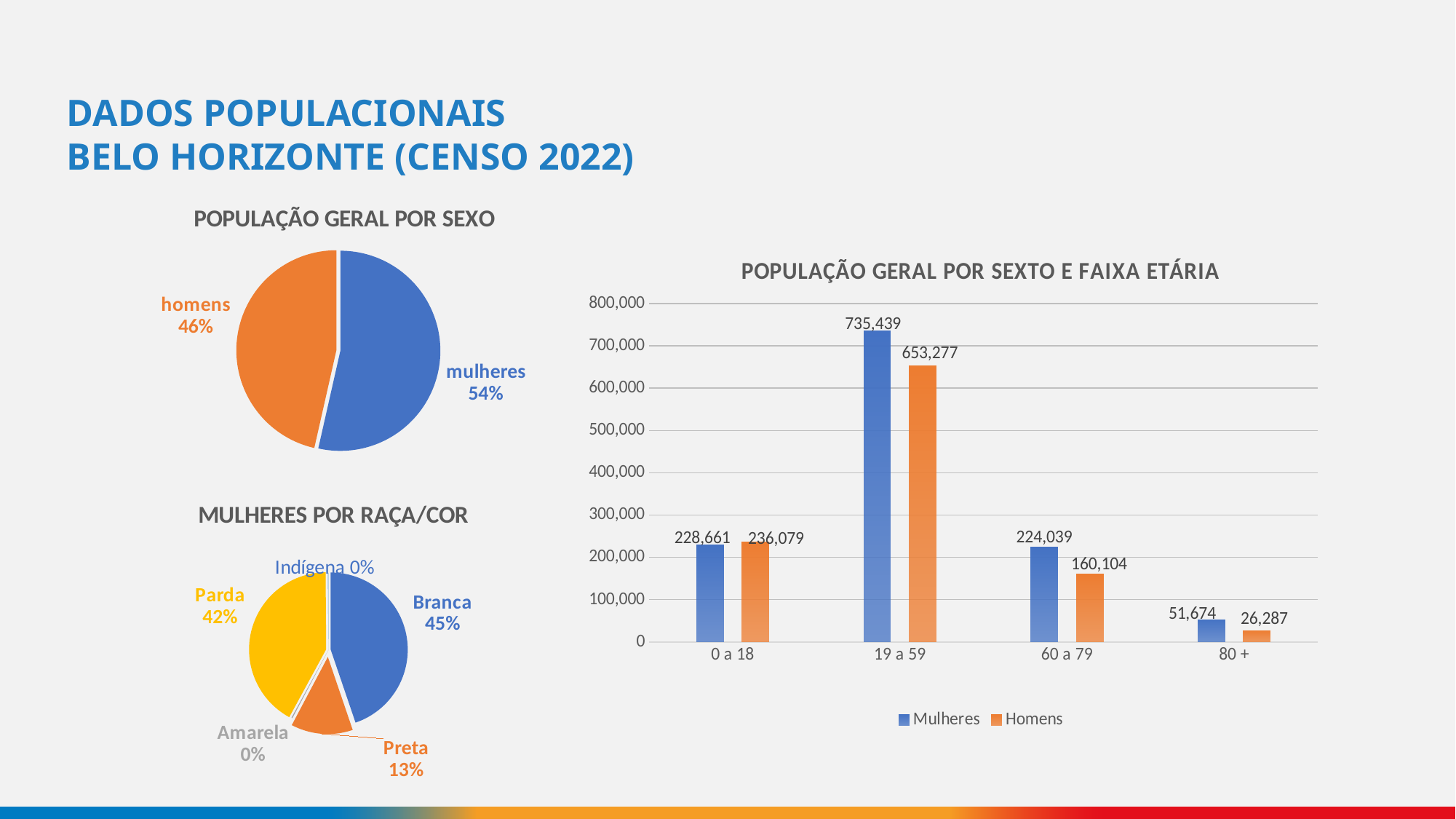
In the chart 'POPULAÇÃO GERAL POR SEXTO E FAIXA ETÁRIA', what is the difference between Mulheres and Homens in the 60 a 79 age group? 63,935 In the chart 'POPULAÇÃO GERAL POR SEXTO E FAIXA ETÁRIA', which is larger in the 0 a 18 age group, Mulheres or Homens? Homens In the chart 'POPULAÇÃO GERAL POR SEXTO E FAIXA ETÁRIA', which age group has the highest value for Homens? 19 a 59 In the chart 'POPULAÇÃO GERAL POR SEXTO E FAIXA ETÁRIA', what is the value for Homens in the 80 + age group? 26,287 How many age groups are shown in the chart 'POPULAÇÃO GERAL POR SEXTO E FAIXA ETÁRIA'? 4 What kind of chart is 'POPULAÇÃO GERAL POR SEXTO E FAIXA ETÁRIA'? Bar chart In the pie chart 'MULHERES POR RAÇA/COR', what share is Parda? 42% In the chart 'POPULAÇÃO GERAL POR SEXTO E FAIXA ETÁRIA', what is the value for Mulheres in the 19 a 59 age group? 735,439 In the chart 'POPULAÇÃO GERAL POR SEXTO E FAIXA ETÁRIA', what is the difference between Mulheres and Homens in the 19 a 59 age group? 82,162 How many series does the legend of the chart 'POPULAÇÃO GERAL POR SEXTO E FAIXA ETÁRIA' list? 2 In the pie chart 'POPULAÇÃO GERAL POR SEXO', what share is mulheres? 54% In the chart 'POPULAÇÃO GERAL POR SEXTO E FAIXA ETÁRIA', which age group has the lowest value for Mulheres? 80 +